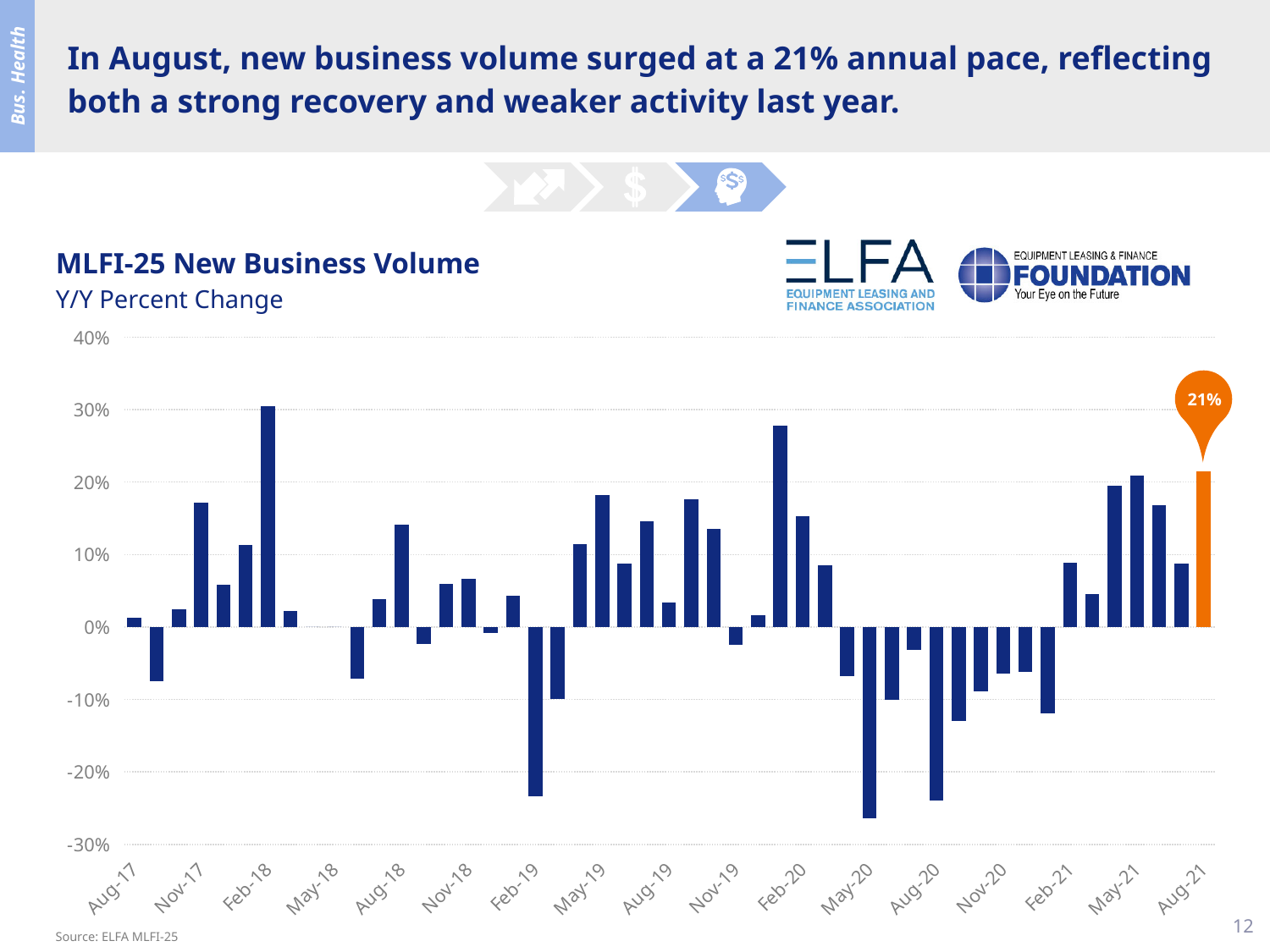
Is the value for Nov-17 greater or less than 10%? greater Is the value for Feb-19 greater or less than -20%? less What kind of chart is used to show MLFI-25 New Business Volume? Bar chart Is the value for Aug-19 greater or less than 10%? less Which is larger, the value for Aug-20 or the value for Aug-21? Aug-21 What is the subtitle shown under the chart title 'MLFI-25 New Business Volume'? Y/Y Percent Change Which is larger, the value for Feb-19 or the value for Feb-20? Feb-20 What is the Y/Y percent change in MLFI-25 new business volume for Aug-21? 21% How many month labels are shown on the x axis of the chart? 17